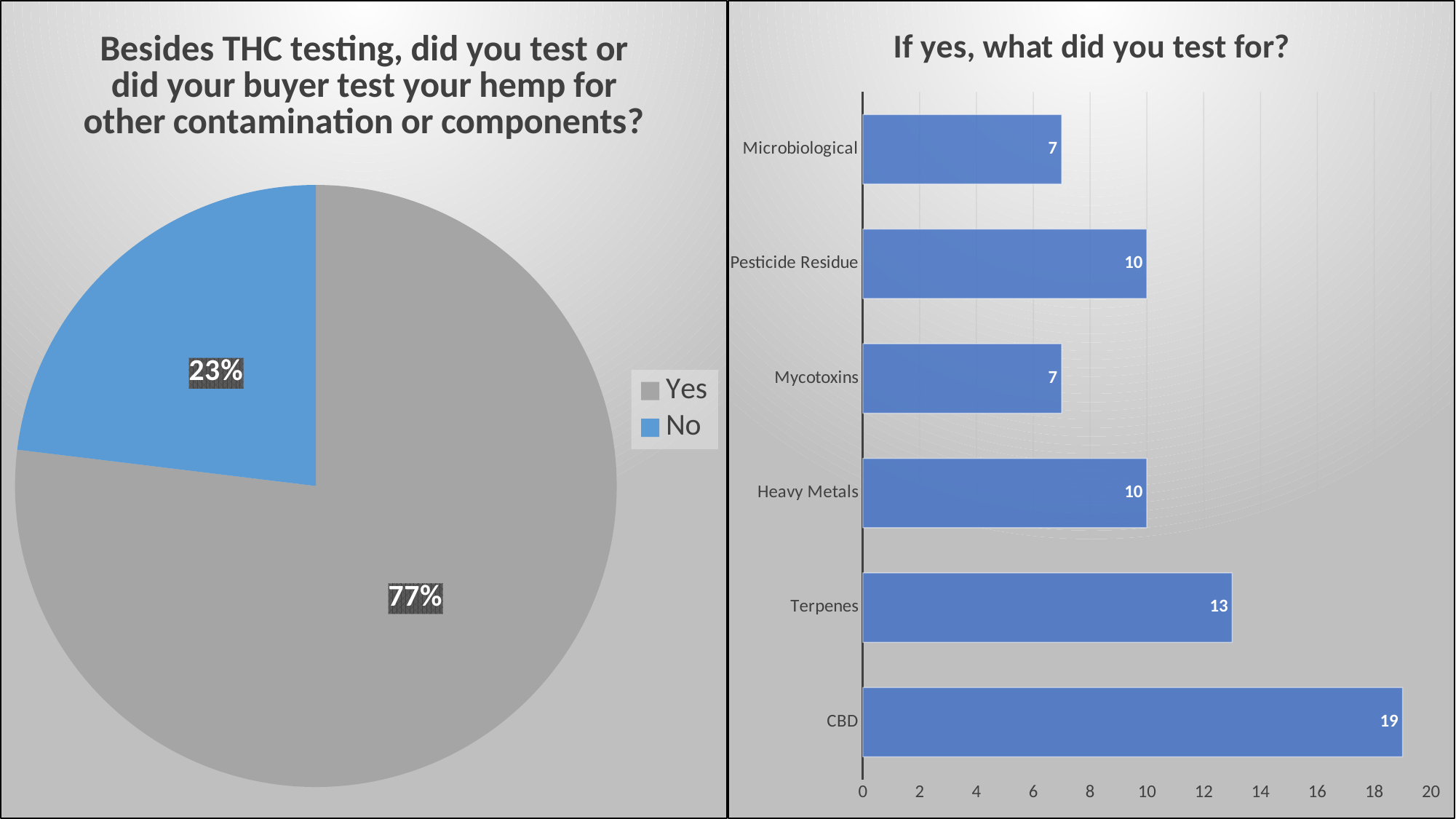
In the chart titled 'If yes, what did you test for?', what is the value for CBD? 19 In the pie chart on the left, what share of respondents answered No? 23% In the pie chart on the left, what share of respondents answered Yes? 77% In the chart titled 'If yes, what did you test for?', how many categories are shown? 6 In the chart titled 'If yes, what did you test for?', which is larger, Pesticide Residue or Mycotoxins? Pesticide Residue In the chart titled 'If yes, what did you test for?', what is the value for Heavy Metals? 10 What kind of chart is the chart on the right? bar chart In the chart titled 'If yes, what did you test for?', which category has the highest value? CBD In the pie chart on the left, how many entries does the legend list? 2 In the chart titled 'If yes, what did you test for?', what is the difference between the values for CBD and Terpenes? 6 What kind of chart is the chart on the left? pie chart In the chart titled 'If yes, what did you test for?', what is the value for Terpenes? 13